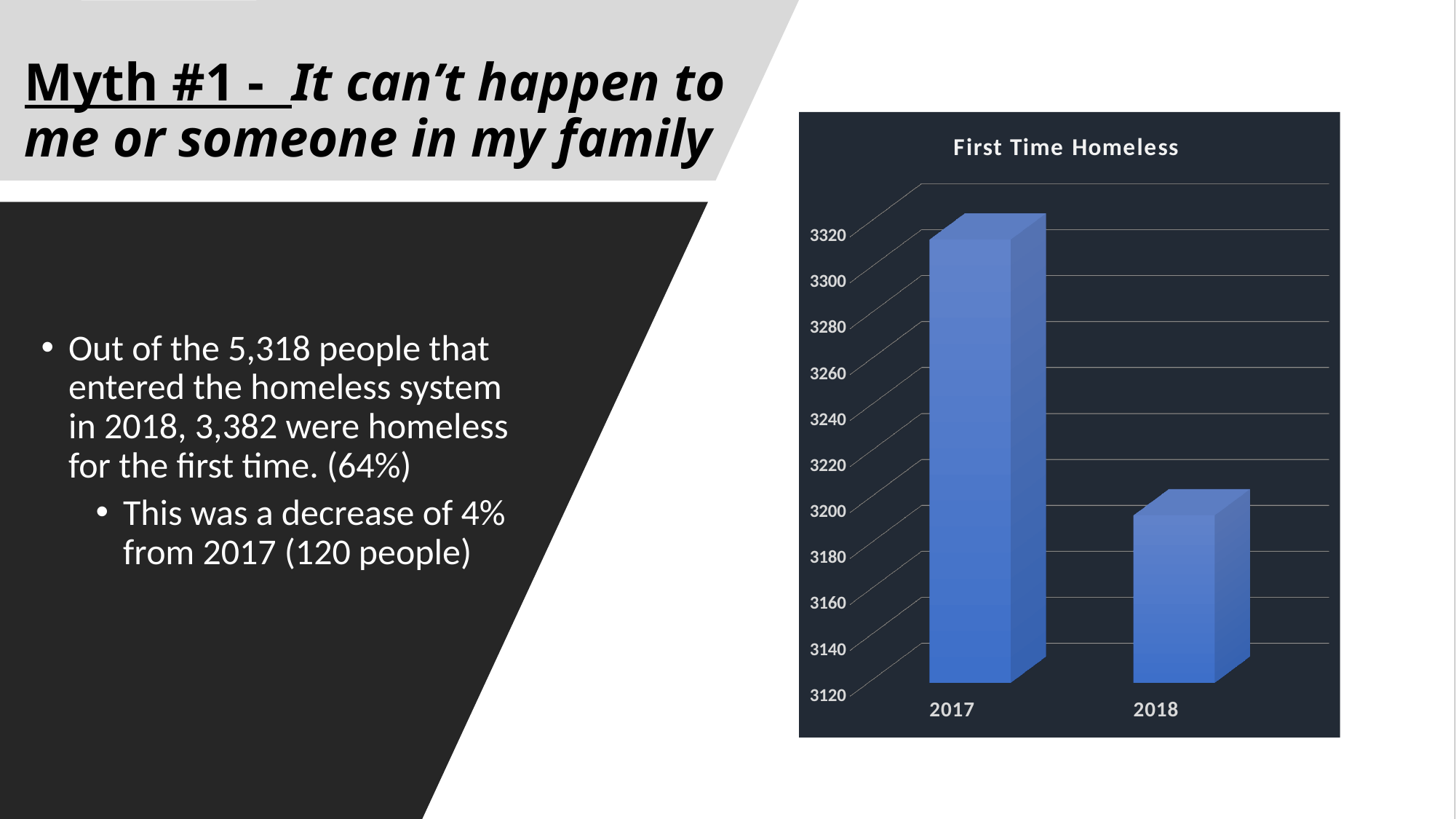
Which is larger in the chart, the value for 2017 or the value for 2018? 2017 Is the value for 2018 greater or less than 3240? less How many categories are plotted on the x axis of the chart? 2 Is the value for 2017 greater or less than 3300? greater What is the title of the chart? First Time Homeless Which year has the highest value in the First Time Homeless chart? 2017 Do the values in the First Time Homeless chart rise or fall from 2017 to 2018? fall Is the value for 2018 greater or less than 3160? greater Which year has the lowest value in the First Time Homeless chart? 2018 What kind of chart is shown on the slide? bar chart What is the lowest tick value shown on the vertical axis of the chart? 3120